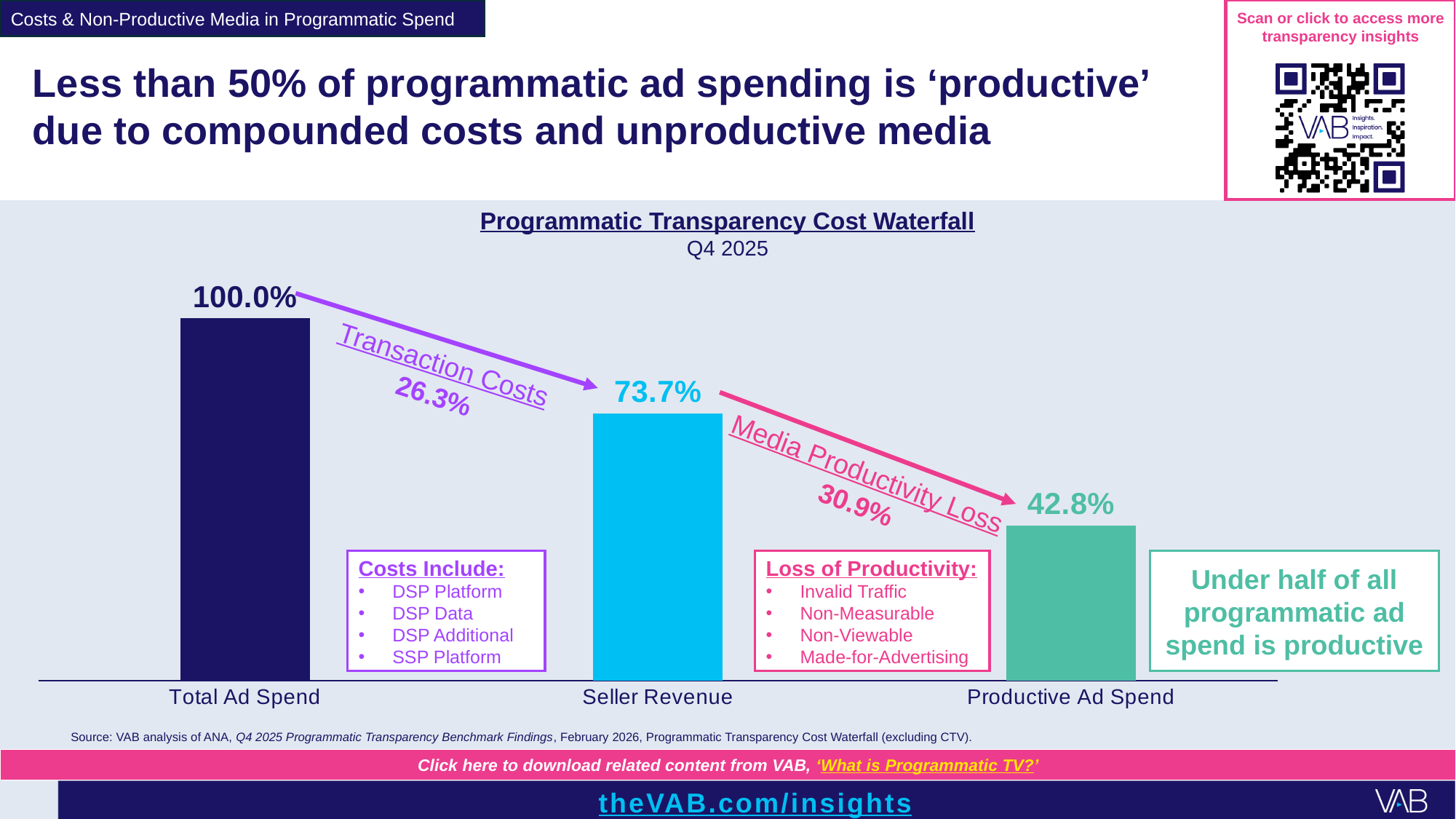
What kind of chart is this? Bar chart What is the value for Productive Ad Spend? 42.8% What is the title of the chart? Programmatic Transparency Cost Waterfall What is the value for Seller Revenue? 73.7% Do the values rise or fall from left to right along the x axis? Fall What is the difference between Seller Revenue and Productive Ad Spend? 30.9% What is the difference between Total Ad Spend and Seller Revenue? 26.3% Which is larger, Seller Revenue or Productive Ad Spend? Seller Revenue Which category has the lowest value? Productive Ad Spend How many categories are shown on the x axis? 3 Which category has the highest value? Total Ad Spend What is the value for Total Ad Spend? 100.0%